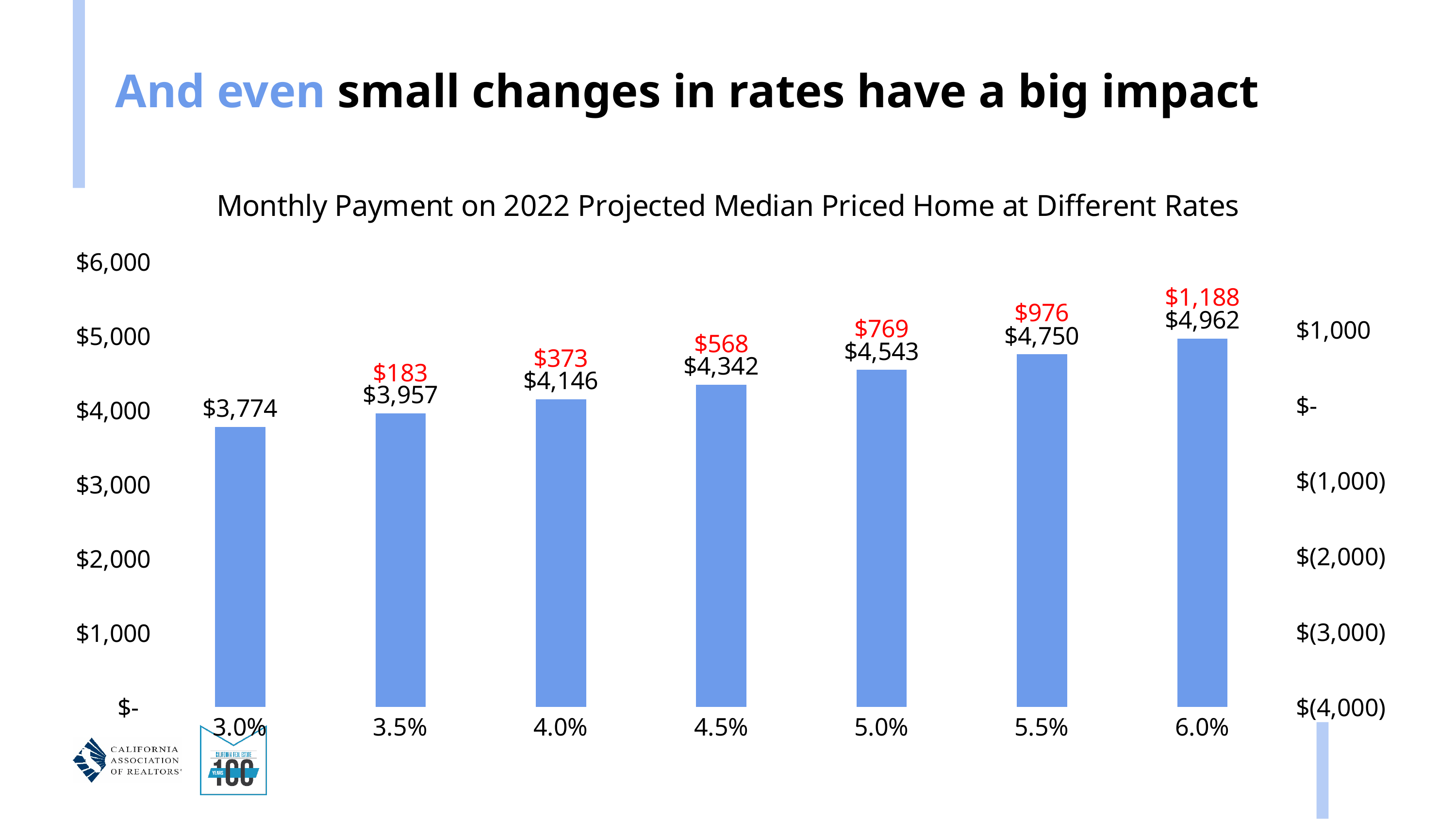
How many rate categories are shown on the x axis? 7 What is the difference between the monthly payment at 5.5% and at 3.0%? $976 What is the monthly payment at a 6.0% rate? $4,962 Is the monthly payment at 3.0% greater or less than $4,000? less Which rate has the lowest monthly payment? 3.0% Which rate has the highest monthly payment? 6.0% Do the monthly payments rise or fall as the rate increases along the x axis? rise What is the red difference label shown above the 5.0% bar? $769 What kind of chart is shown on the slide? bar chart Which is larger, the monthly payment at 4.5% or at 5.5%? 5.5% What is the monthly payment at a 4.0% rate? $4,146 What is the difference between the monthly payment at 4.5% and at 3.5%? $385